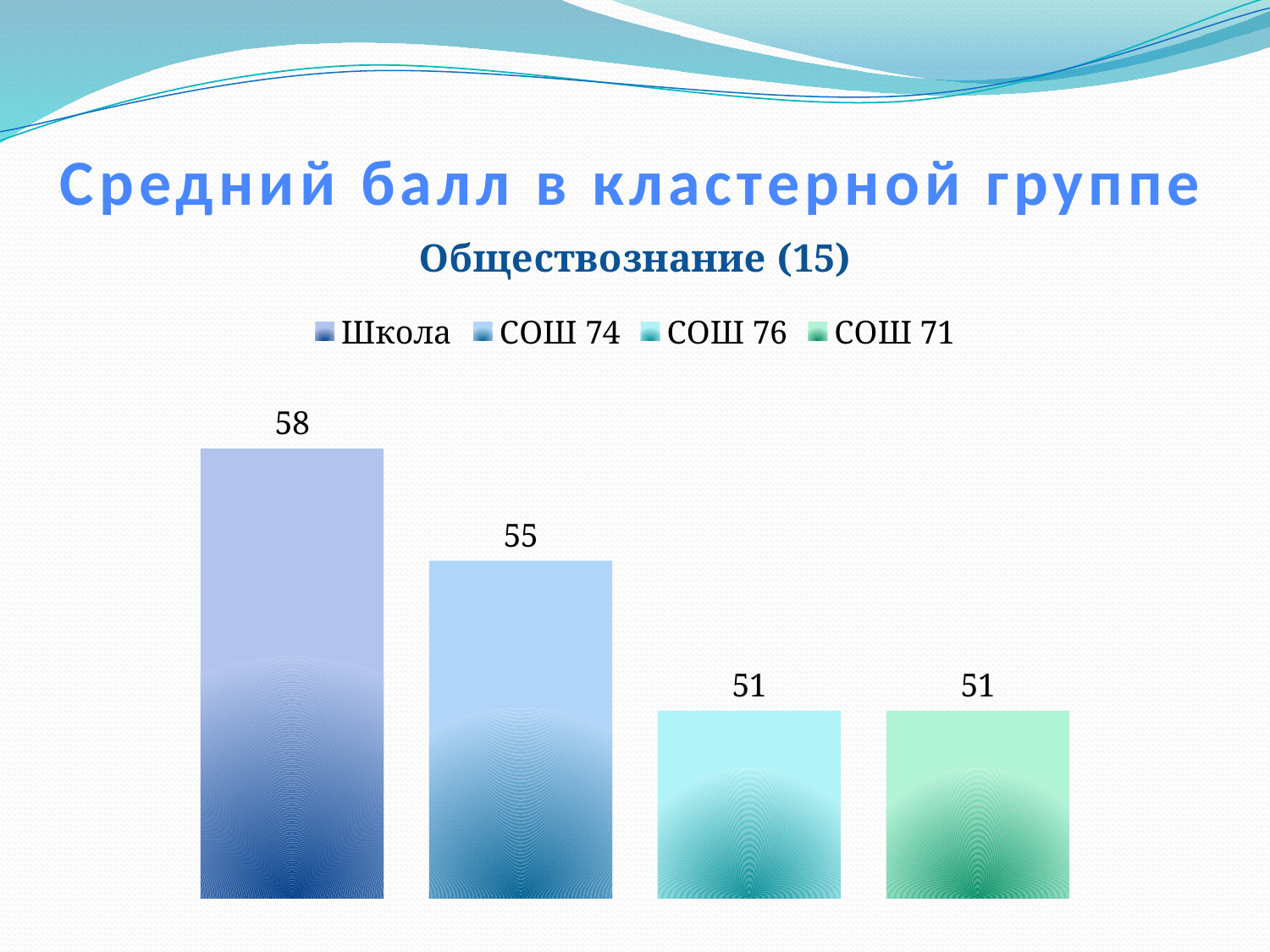
How many series does the legend list? 4 What is the value for Школа? 58 What is the value for СОШ 74? 55 What is the difference between the values for Школа and СОШ 76? 7 What is the difference between the values for Школа and СОШ 74? 3 What is the value for СОШ 76? 51 Which is larger, the value for СОШ 74 or the value for СОШ 71? СОШ 74 What is the value for СОШ 71? 51 How many bars are plotted in the chart? 4 What kind of chart is shown on the slide? Bar chart Which series has the highest value? Школа What is the title of the chart? Обществознание (15)